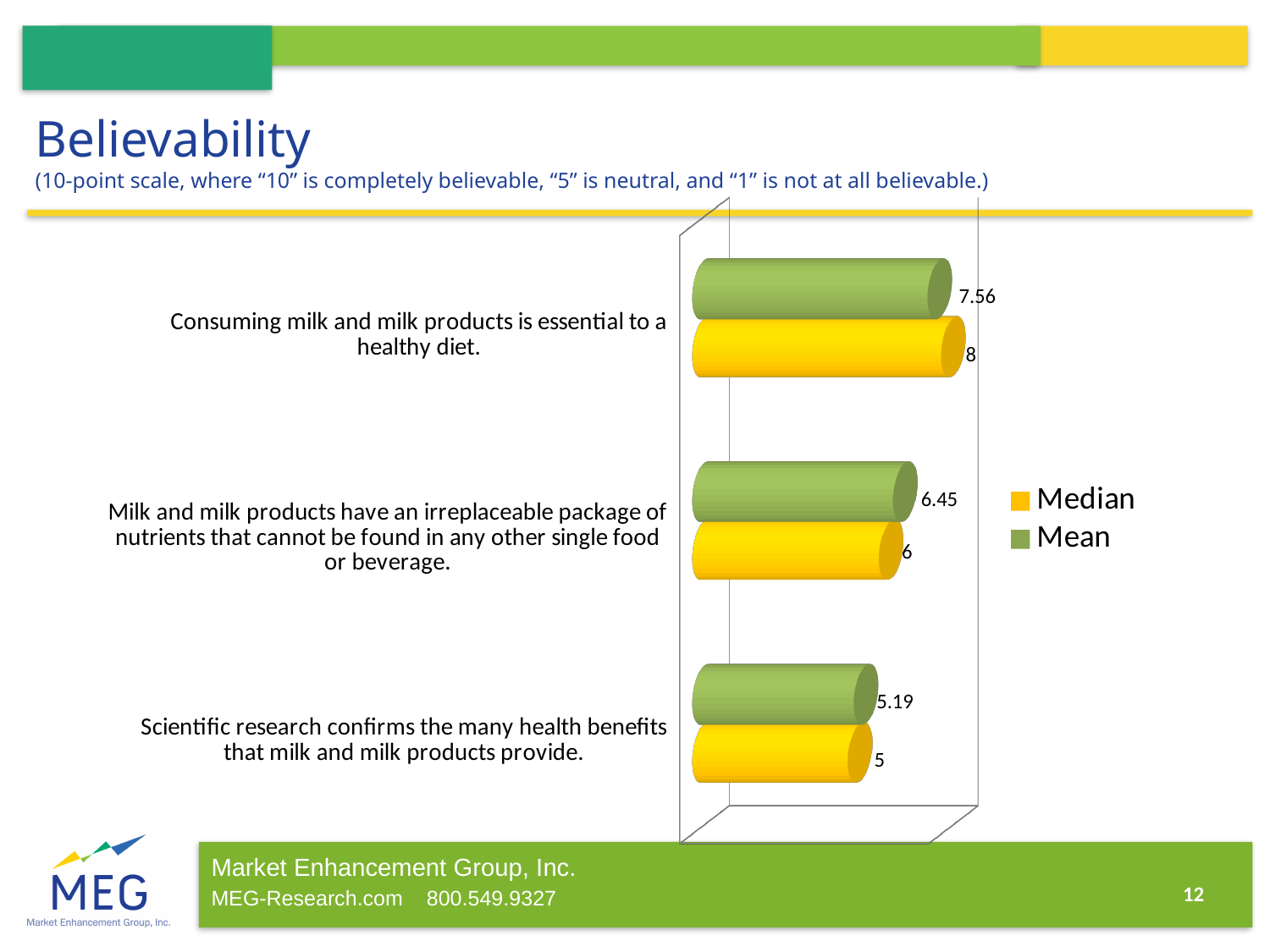
What is the Mean value for "Consuming milk and milk products is essential to a healthy diet."? 7.56 Which statement has the lowest Median value? Scientific research confirms the many health benefits that milk and milk products provide. What is the difference between the Mean values for "Consuming milk and milk products is essential to a healthy diet." and "Scientific research confirms the many health benefits that milk and milk products provide."? 2.37 Which statement has the highest Mean value? Consuming milk and milk products is essential to a healthy diet. What is the Mean value for "Scientific research confirms the many health benefits that milk and milk products provide."? 5.19 Which colour represents the Median series in the chart? Yellow How many series does the legend list? 2 What is the Median value for "Consuming milk and milk products is essential to a healthy diet."? 8 Which is larger for "Milk and milk products have an irreplaceable package of nutrients...": the Mean or the Median? Mean How many statements are plotted in the chart? 3 What is the Median value for "Milk and milk products have an irreplaceable package of nutrients that cannot be found in any other single food or beverage."? 6 What kind of chart is shown on the slide? Bar chart